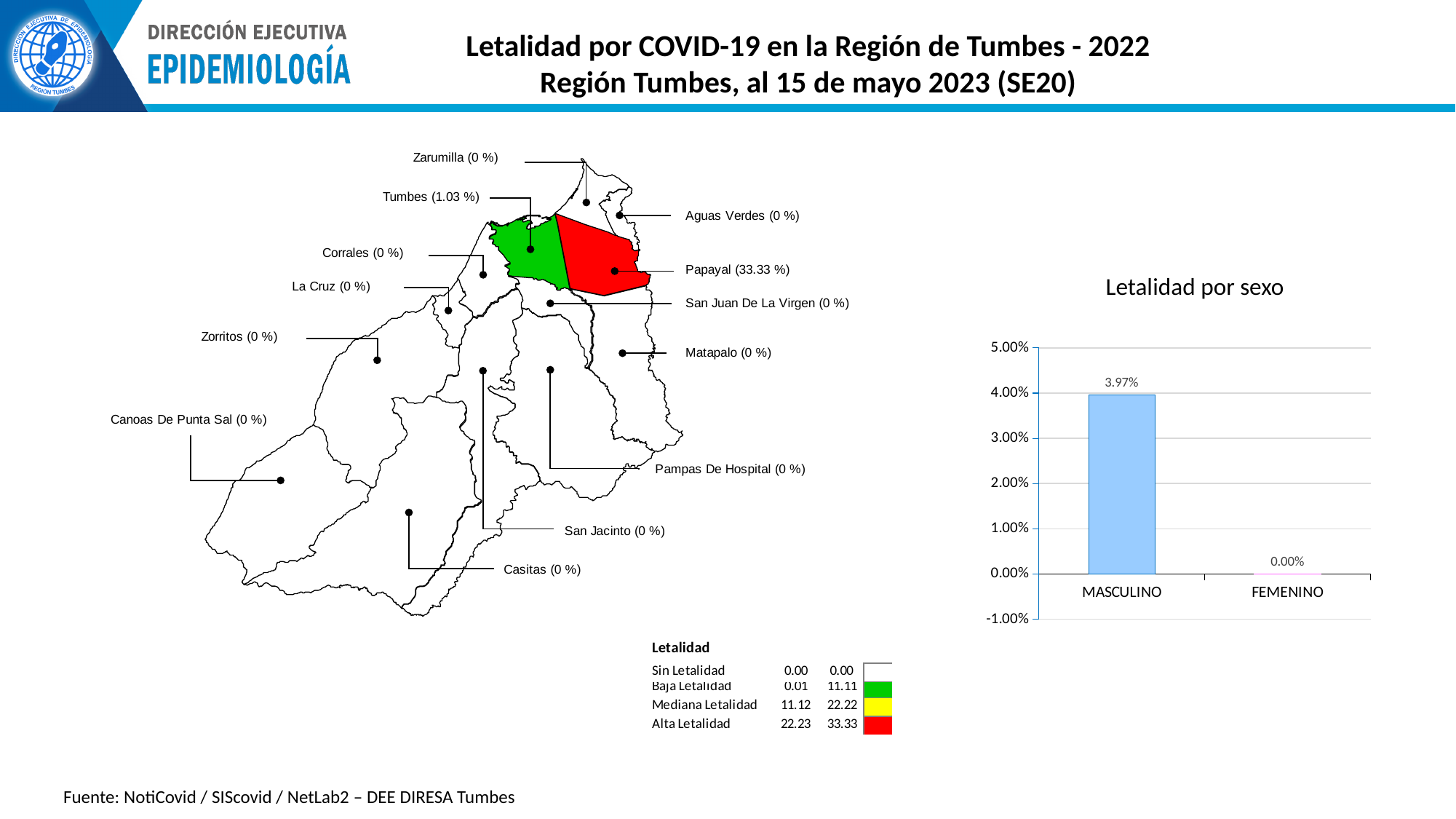
What kind of chart is 'Letalidad por sexo'? bar chart How many categories are shown on the x axis of the 'Letalidad por sexo' chart? 2 On the map on the left, what is the lethality value shown for Tumbes? 1.03 % On the map on the left, what is the lethality value shown for Papayal? 33.33 % In the 'Letalidad por sexo' chart, what is the value for MASCULINO? 3.97% What is the title of the chart on the right side of the slide? Letalidad por sexo In the 'Letalidad por sexo' chart, is the value for MASCULINO greater or less than 3.00%? greater In the 'Letalidad por sexo' chart, which category has the highest value? MASCULINO In the 'Letalidad por sexo' chart, which category has the lowest value? FEMENINO On the map on the left, which district is shaded red (Alta Letalidad)? Papayal In the 'Letalidad por sexo' chart, what is the difference between the MASCULINO and FEMENINO values? 3.97% In the 'Letalidad por sexo' chart, what is the value for FEMENINO? 0.00%